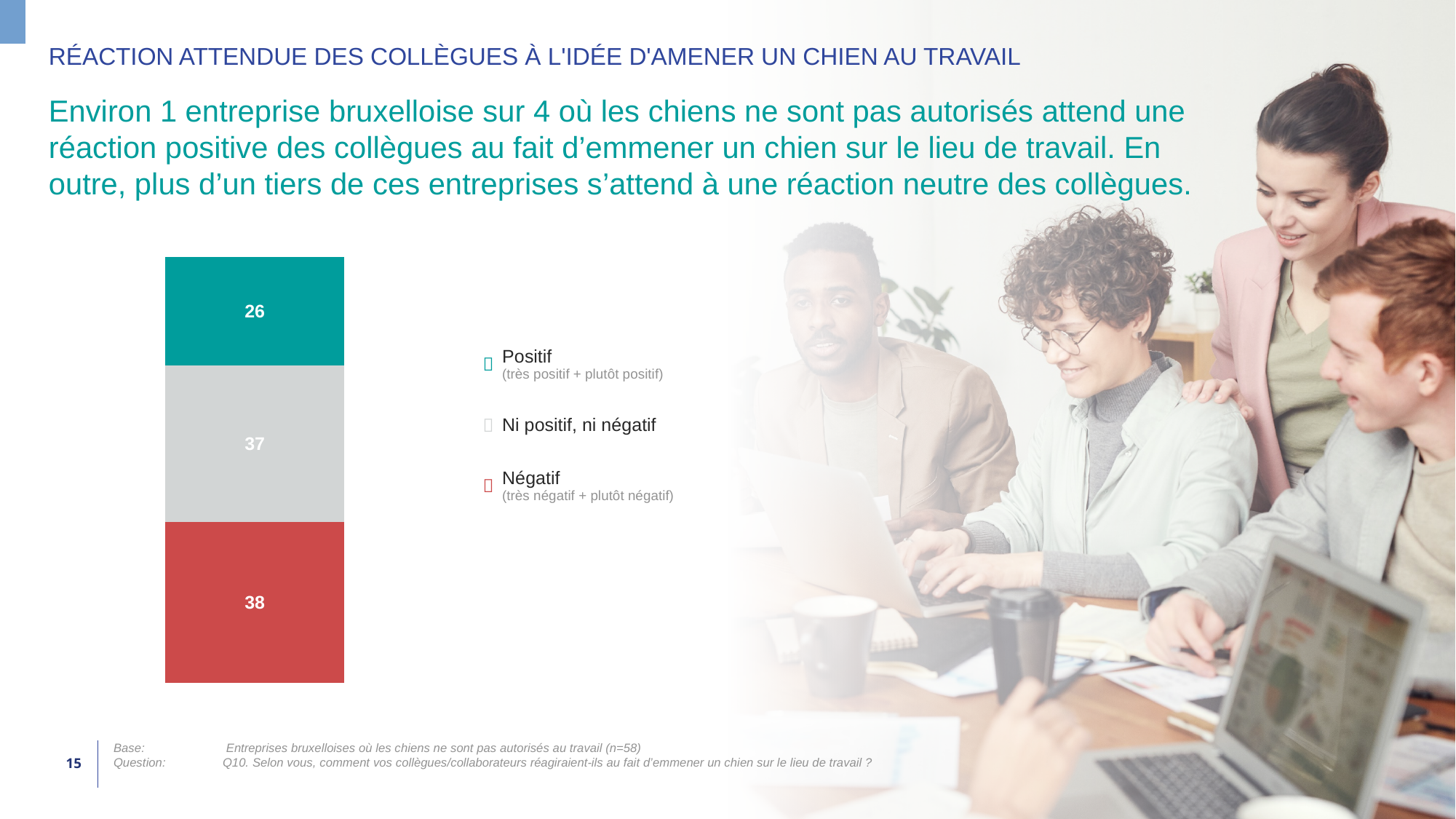
What kind of chart is shown on the slide? Stacked bar chart What is the difference between the Ni positif, ni négatif value and the Positif value? 11 What value is shown for the Positif segment of the stacked bar? 26 Which is larger, the value for Positif or the value for Négatif? Négatif Which category has the lowest value in the stacked bar? Positif How many entries does the legend list? 3 How many segments does the stacked bar contain? 3 What colour is the Négatif segment of the stacked bar? Red Which category has the highest value in the stacked bar? Négatif What is the difference between the Négatif value and the Positif value? 12 What value is shown for the Ni positif, ni négatif segment of the stacked bar? 37 What value is shown for the Négatif segment of the stacked bar? 38